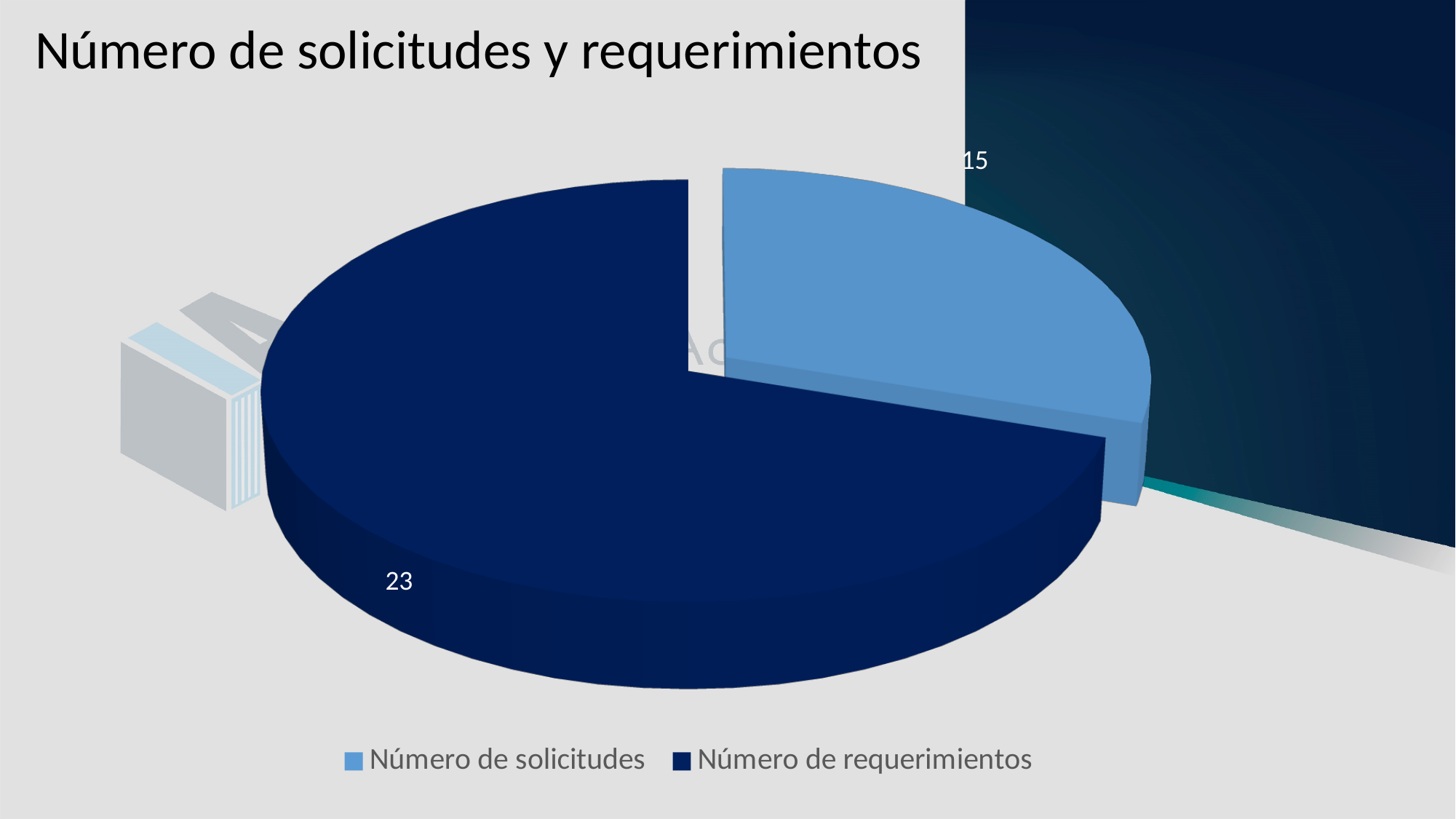
What is the value for Número de solicitudes? 15 Which legend entry is shown in dark navy blue? Número de requerimientos What is the title of the chart? Número de solicitudes y requerimientos Which category has the smallest slice of the pie? Número de solicitudes Which is larger, Número de solicitudes or Número de requerimientos? Número de requerimientos What is the value for Número de requerimientos? 23 What is the difference between Número de requerimientos and Número de solicitudes? 8 What is the total of the two slices in the pie chart? 38 How many slices does the pie chart have? 2 How many entries does the legend list? 2 What kind of chart is shown on the slide? Pie chart Which category has the largest slice of the pie? Número de requerimientos